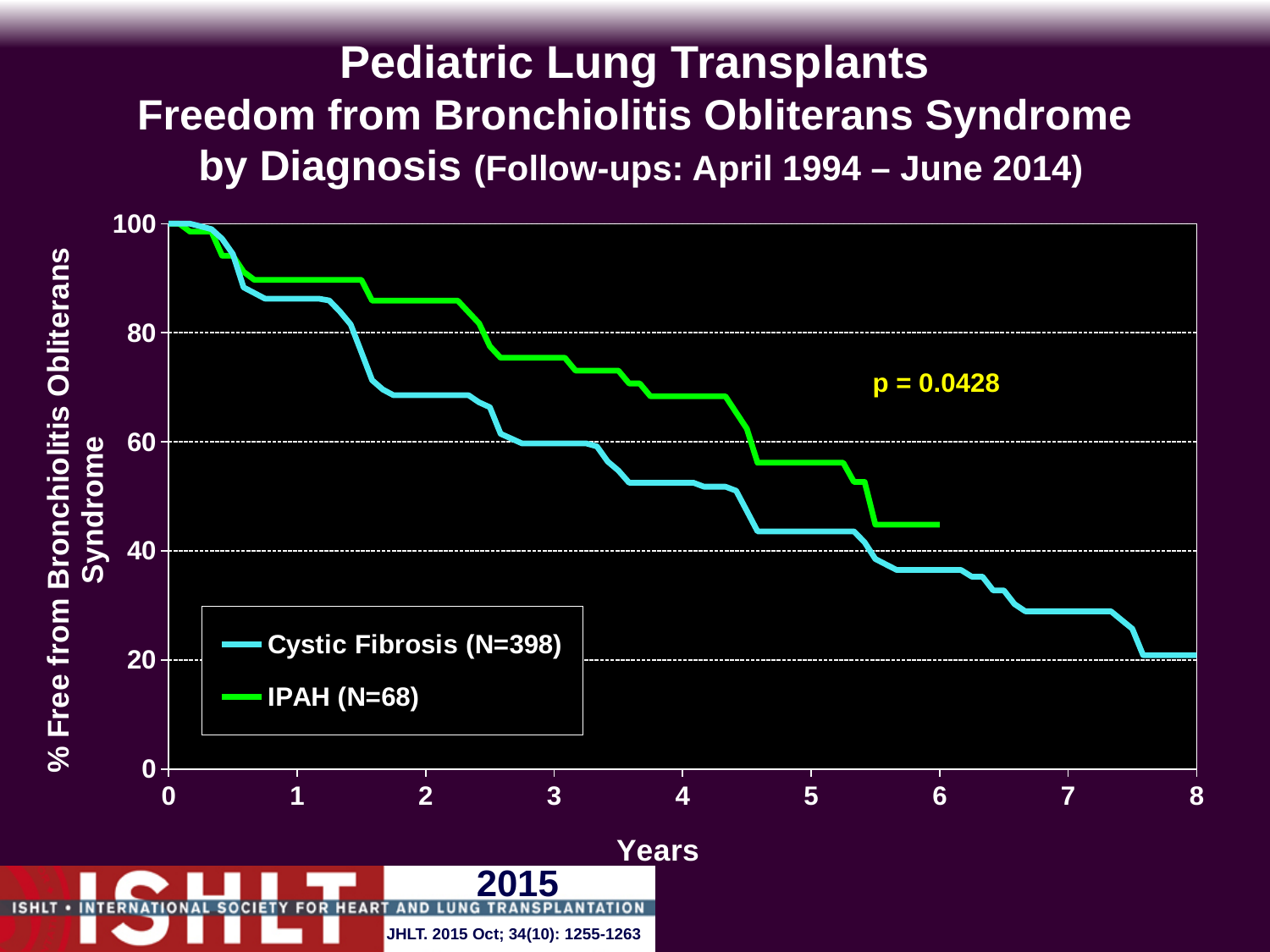
Is the value for Cystic Fibrosis at 4 years greater or less than 60? less What is the N for the Cystic Fibrosis series in the legend? 398 How many series does the legend list? 2 Is the value for Cystic Fibrosis at 6 years greater or less than 40? less Do the values for Cystic Fibrosis rise or fall as the years increase? Fall At 5 years, which series has the lower value, Cystic Fibrosis or IPAH? Cystic Fibrosis Is the value for IPAH at 2 years greater or less than 80? greater What kind of chart is shown on the slide? Line chart At 3 years, which series has the higher value, Cystic Fibrosis or IPAH? IPAH What p-value is shown on the chart? p = 0.0428 Do the values for IPAH rise or fall as the years increase? Fall